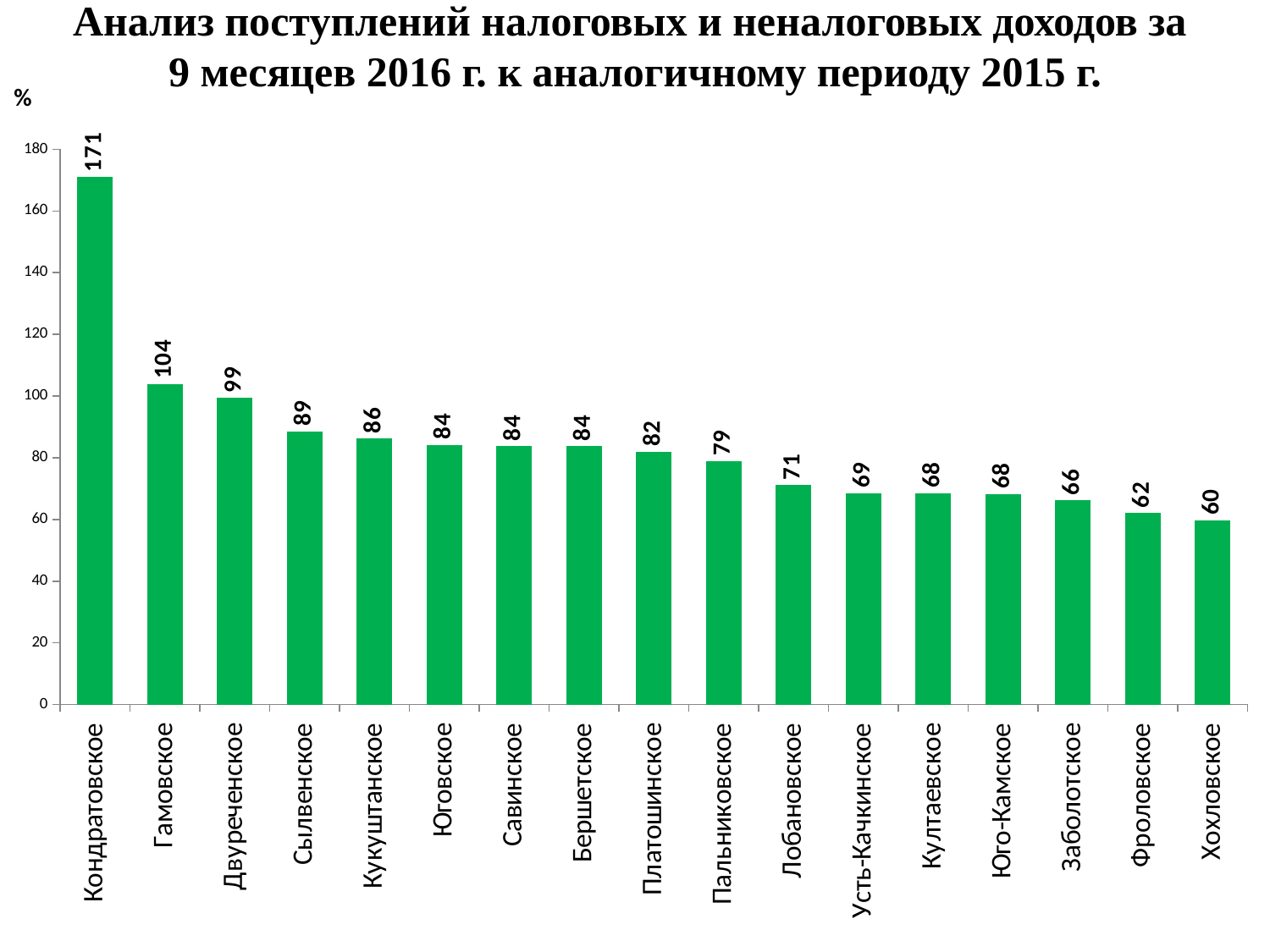
Which category has the lowest value? Хохловское How many categories are shown on the x axis? 17 Which category has the highest value? Кондратовское What is the difference between the values for Кондратовское and Гамовское? 67 What is the value for Хохловское? 60 What is the value for Кондратовское? 171 What is the value for Пальниковское? 79 Which is larger, the value for Сылвенское or the value for Лобановское? Сылвенское What unit is indicated at the top of the vertical axis? % What is the value for Гамовское? 104 Do the values generally rise or fall from left to right along the x axis? fall What kind of chart is shown on the slide? bar chart